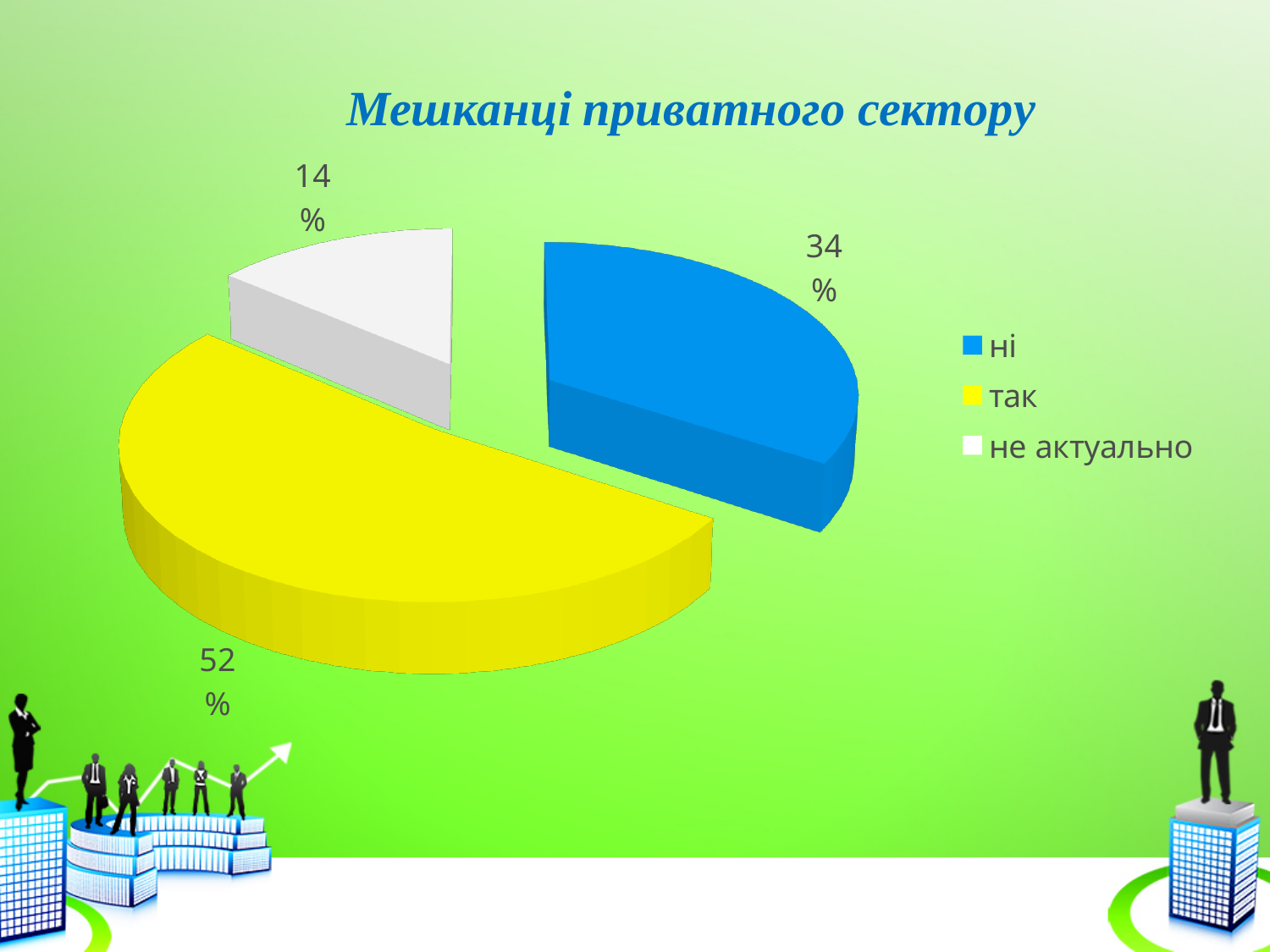
What kind of chart is shown on the slide? pie chart Which category has the smallest share of the pie? не актуально How many slices does the pie chart have? 3 How many entries does the legend list? 3 What is the difference in percentage points between the "так" slice and the "ні" slice? 18 What percentage is shown for the "ні" slice? 34% What colour is the "так" slice? yellow Which is larger, the share for "ні" or the share for "не актуально"? ні What percentage is shown for the "не актуально" slice? 14% Which category has the largest share of the pie? так What percentage is shown for the "так" slice? 52% What is the title of the chart? Мешканці приватного сектору